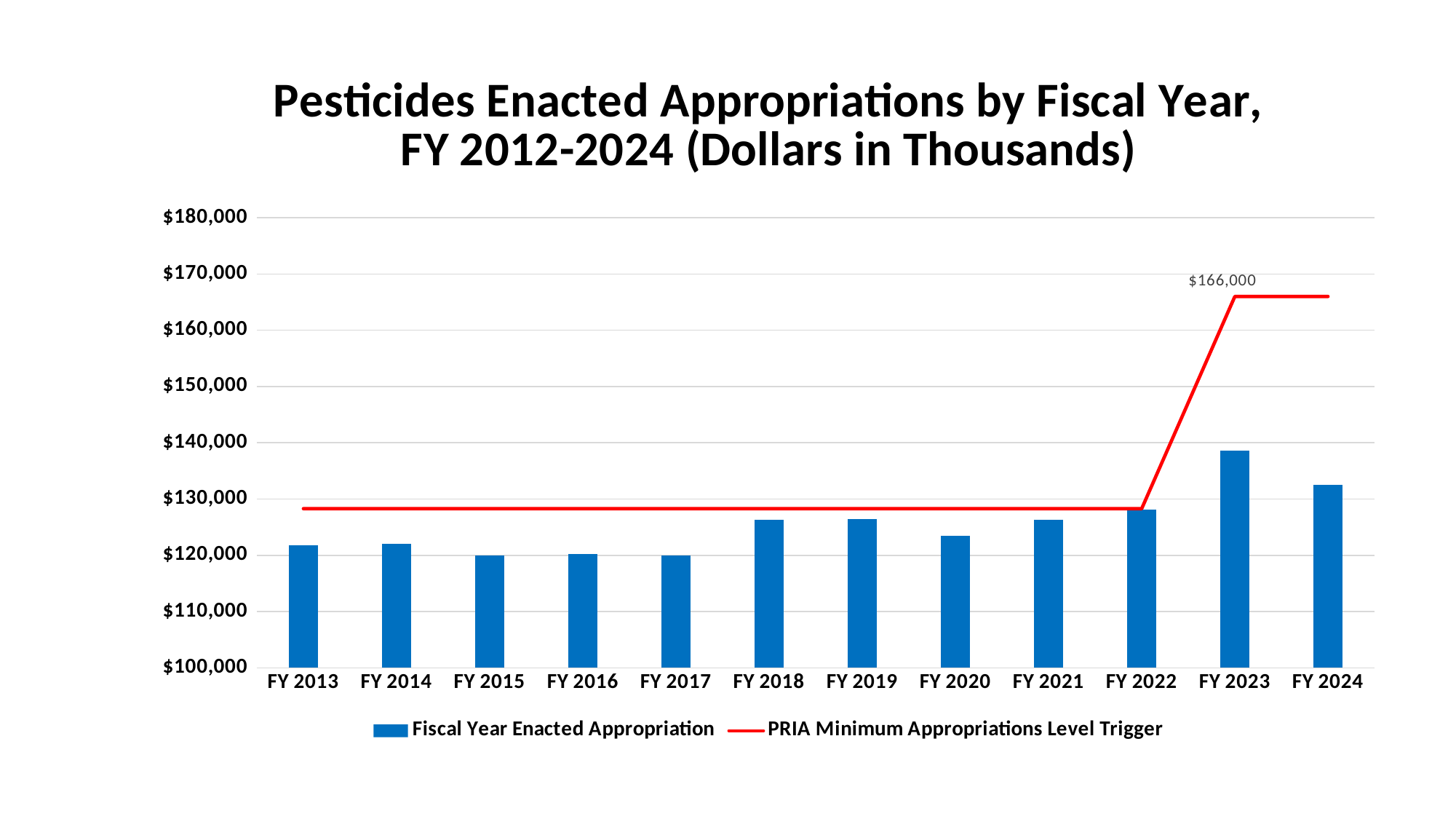
Is the Fiscal Year Enacted Appropriation for FY 2023 greater or less than $130,000? greater How many series does the legend list? 2 Which is larger, the Fiscal Year Enacted Appropriation for FY 2023 or for FY 2024? FY 2023 Which is larger, the Fiscal Year Enacted Appropriation for FY 2018 or for FY 2015? FY 2018 What is the value of the PRIA Minimum Appropriations Level Trigger in FY 2023? $166,000 Is the Fiscal Year Enacted Appropriation for FY 2024 greater or less than $130,000? greater Is the Fiscal Year Enacted Appropriation for FY 2018 greater or less than $130,000? less Which fiscal year has the highest Fiscal Year Enacted Appropriation bar? FY 2023 What is the title of the chart? Pesticides Enacted Appropriations by Fiscal Year, FY 2012-2024 (Dollars in Thousands) What colour is the PRIA Minimum Appropriations Level Trigger line? Red How many fiscal years are shown on the x axis? 12